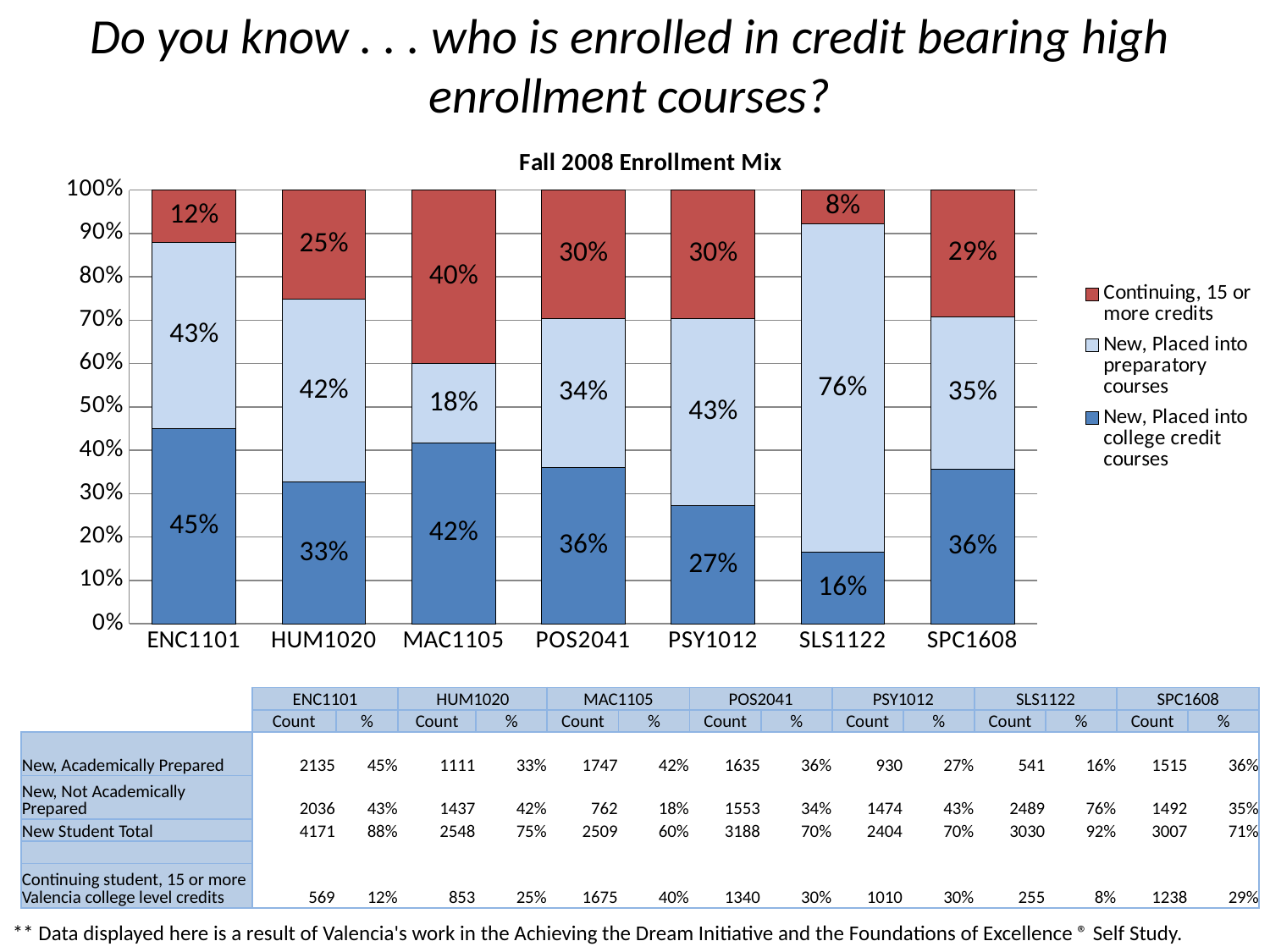
What is the title of the chart? Fall 2008 Enrollment Mix In the Fall 2008 Enrollment Mix chart, what percentage of MAC1105 students are Continuing, 15 or more credits? 40% What type of chart is shown on the slide? Stacked bar chart Which course has the lowest percentage of students who are New, Placed into preparatory courses? MAC1105 Which course has the lowest percentage of students who are Continuing, 15 or more credits? SLS1122 How many series does the chart legend list? 3 What is the difference between the Continuing, 15 or more credits percentage for MAC1105 and for ENC1101? 28% Which is larger: the New, Placed into college credit courses percentage for HUM1020 or for POS2041? POS2041 In the Fall 2008 Enrollment Mix chart, what percentage of PSY1012 students are New, Placed into college credit courses? 27% In the Fall 2008 Enrollment Mix chart, what percentage of SLS1122 students are New, Placed into preparatory courses? 76% How many courses are shown on the x axis of the chart? 7 Which course has the highest percentage of students who are New, Placed into college credit courses? ENC1101